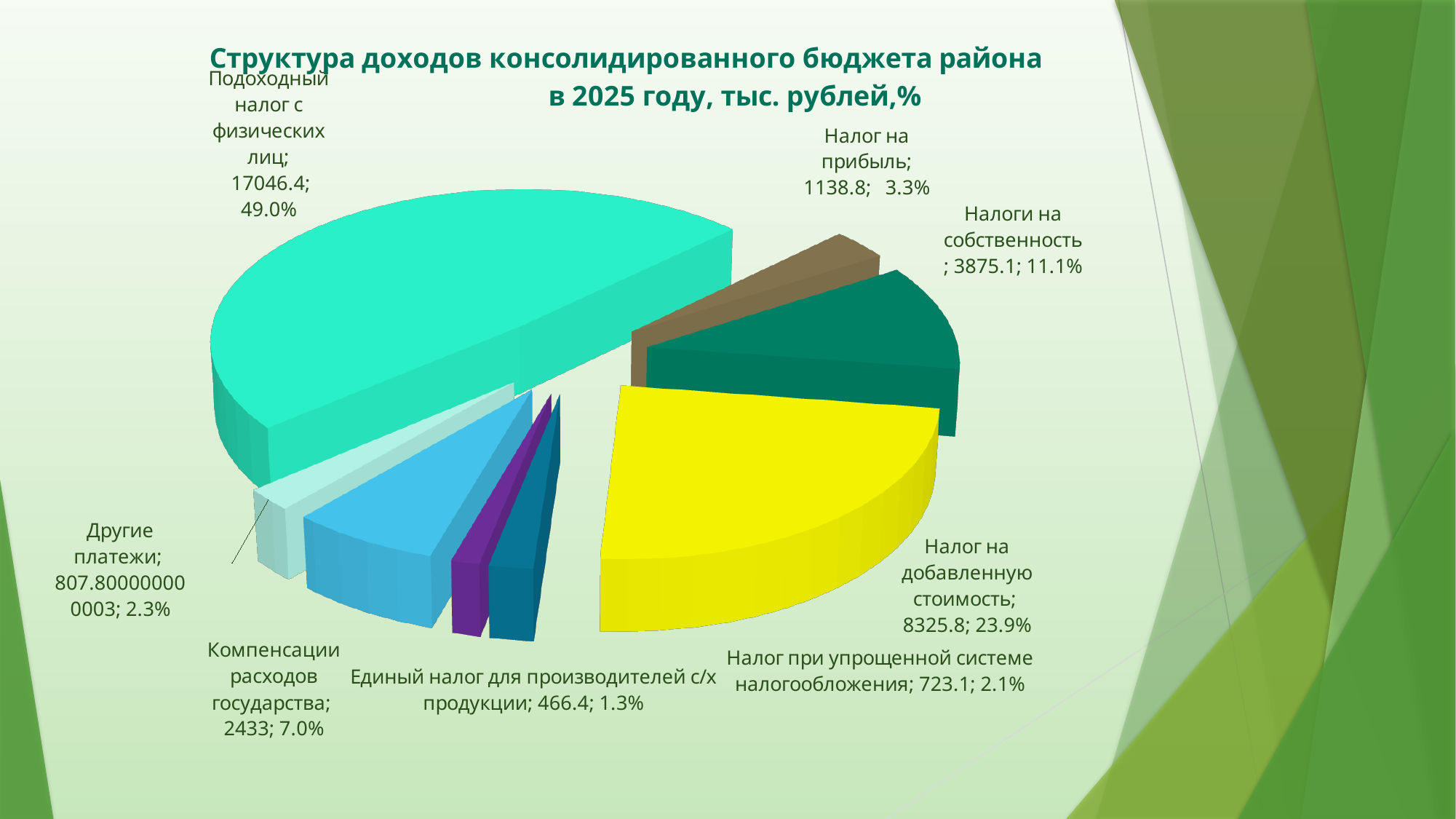
What is the value for Компенсации расходов государства? 2433 What kind of chart is shown on the slide? Pie chart How many categories (slices) does the pie chart show? 8 What share of the pie does Налог на прибыль represent? 3.3% What share of the pie does Налог на добавленную стоимость represent? 23.9% What is the difference between the values for Налог на добавленную стоимость and Налоги на собственность? 4450.7 What is the value for Подоходный налог с физических лиц? 17046.4 Which category has the largest share of the pie? Подоходный налог с физических лиц Which is larger: Налог при упрощенной системе налогообложения or Налоги на собственность? Налоги на собственность What is the value for Налоги на собственность? 3875.1 What is the value for Налог на добавленную стоимость? 8325.8 Which category has the smallest share of the pie? Единый налог для производителей с/х продукции